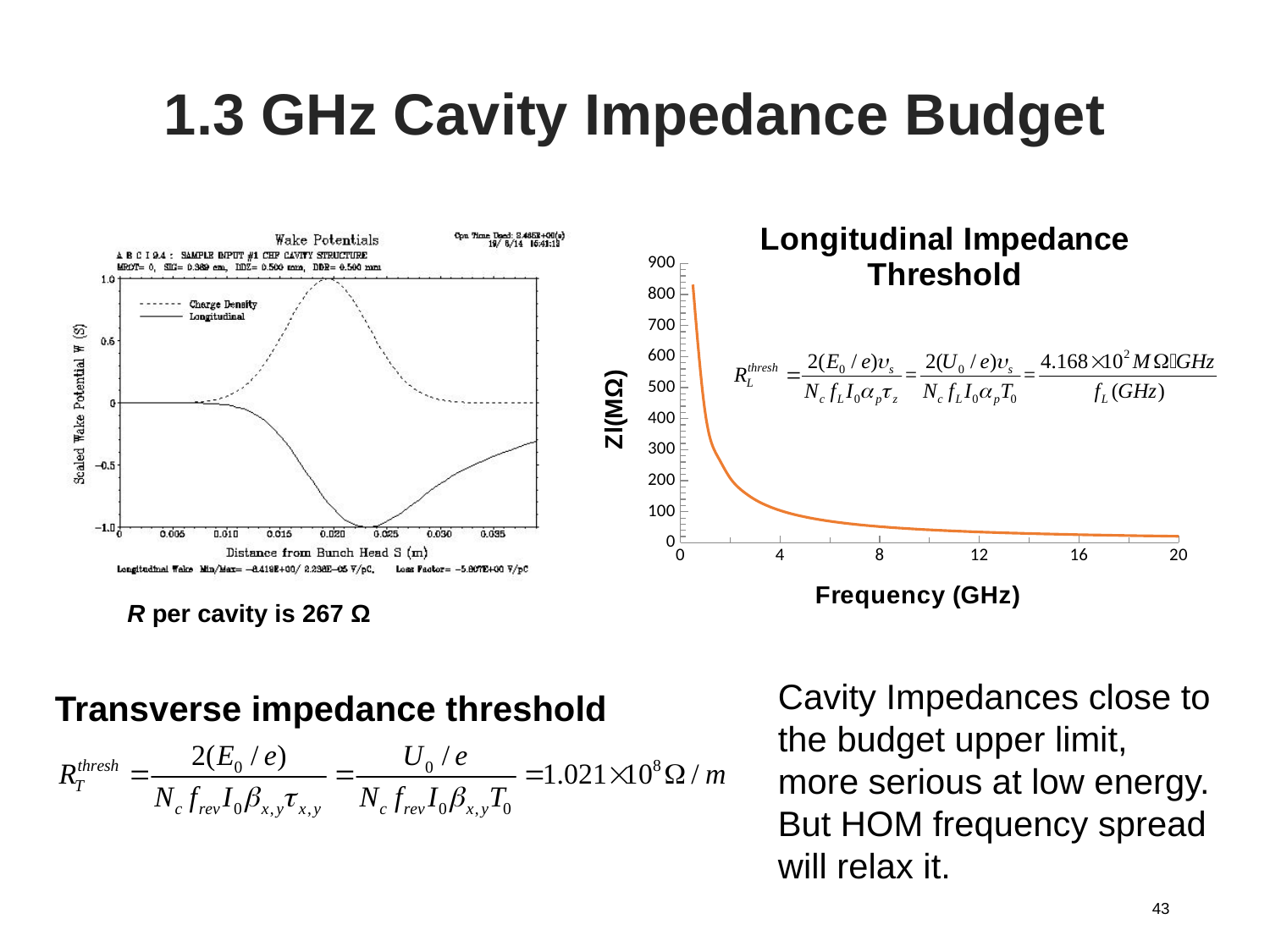
What kind of chart is the Longitudinal Impedance Threshold chart? line chart How many series does the legend of the Wake Potentials chart list? 2 In the Wake Potentials chart, which series reaches the peak value of 1.0? Charge Density What kind of chart is the Wake Potentials chart? line chart In the Wake Potentials chart, which series has the larger value at 0.020 m, Charge Density or Longitudinal? Charge Density In the Longitudinal Impedance Threshold chart, is the value at 16 GHz greater or less than 100? less In the Longitudinal Impedance Threshold chart, is the value at 4 GHz greater or less than 200? less What are the two legend entries in the Wake Potentials chart? Charge Density and Longitudinal In the Longitudinal Impedance Threshold chart, is the value at 2 GHz greater or less than 100? greater In the Longitudinal Impedance Threshold chart, does the impedance rise or fall as frequency increases? fall What is the x-axis label of the Longitudinal Impedance Threshold chart? Frequency (GHz)